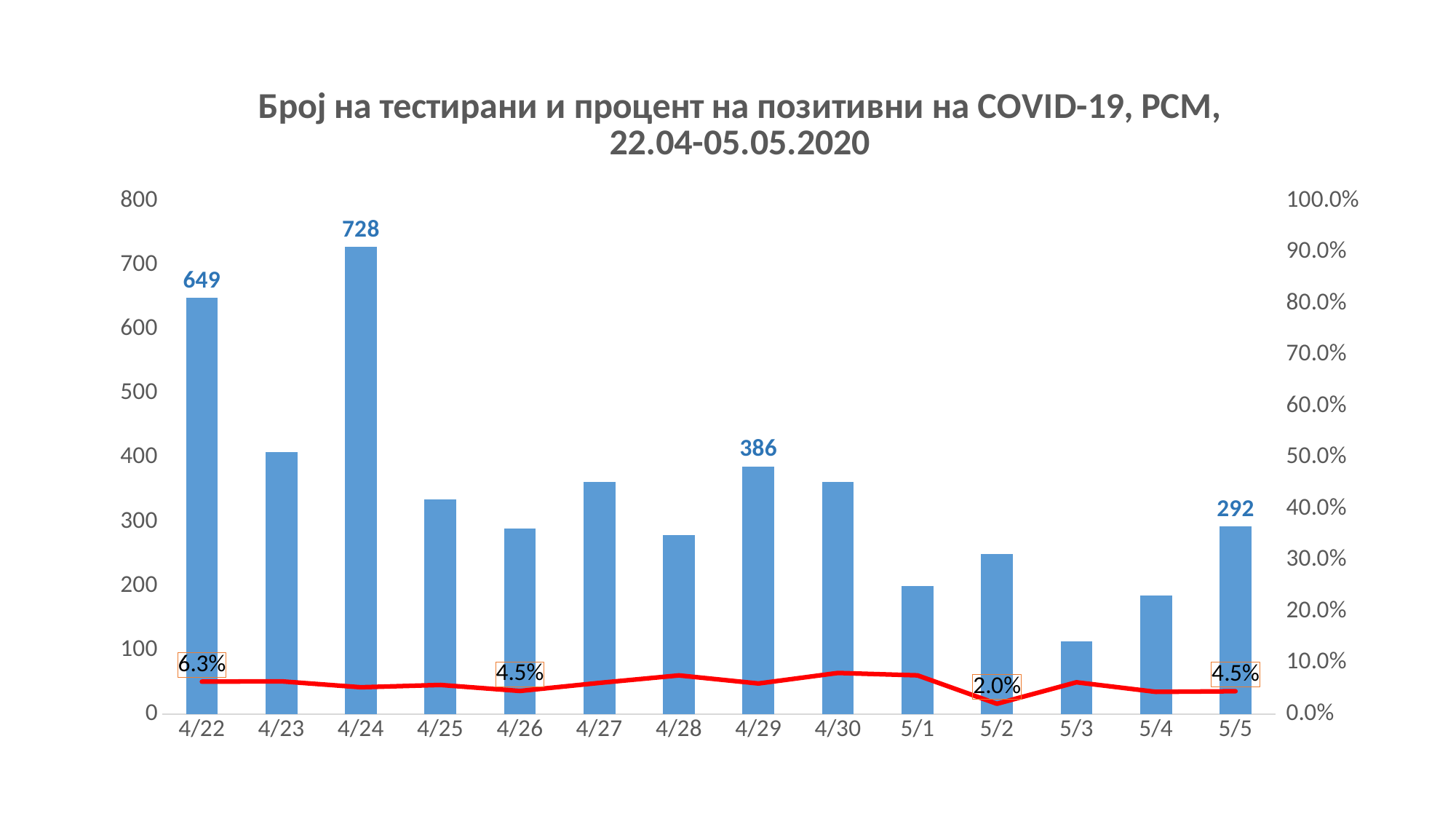
What kind of chart is this? A bar chart combined with a line chart How many more people were tested on 4/24 than on 4/22? 79 Which date had more people tested, 4/29 or 5/5? 4/29 What is the number of tested shown for 5/5? 292 On which date was the number of tested the lowest? 5/3 What percentage of positives is labelled on the line for 5/2? 2.0% On which date was the number of tested the highest? 4/24 What percentage of positives is labelled on the line for 4/22? 6.3% How many people were tested on 4/24? 728 What is the number of tested shown for 4/22? 649 How many dates are shown on the x axis? 14 Is the number of tested on 5/3 greater or less than 200? less